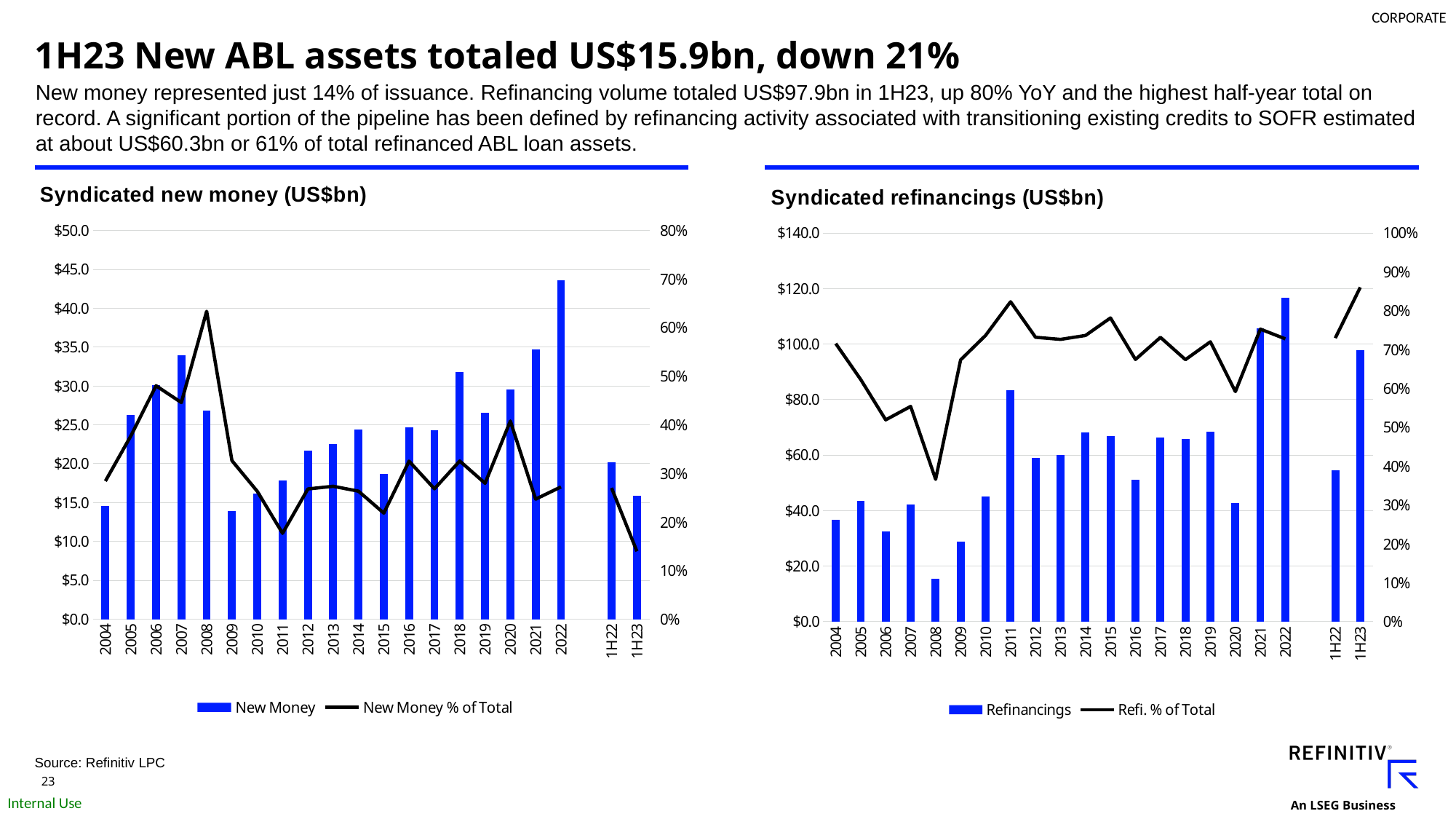
How many series does the legend of the 'Syndicated new money (US$bn)' chart list? 2 On the 'Syndicated new money (US$bn)' chart, which is larger, the New Money bar for 2021 or for 2018? 2021 On the 'Syndicated refinancings (US$bn)' chart, which year has the tallest Refinancings bar? 2022 On the 'Syndicated new money (US$bn)' chart, is the New Money % of Total for 1H23 greater or less than 20%? less How many categories are shown on the x axis of the 'Syndicated refinancings (US$bn)' chart? 21 On the 'Syndicated new money (US$bn)' chart, do the New Money bars rise or fall from 2019 to 2022? rise On the 'Syndicated new money (US$bn)' chart, is the New Money bar for 2022 greater or less than $40.0? greater On the 'Syndicated new money (US$bn)' chart, is the New Money bar for 2011 greater or less than $20.0? less On the 'Syndicated refinancings (US$bn)' chart, which year has the shortest Refinancings bar? 2008 On the 'Syndicated new money (US$bn)' chart, which year has the tallest New Money bar? 2022